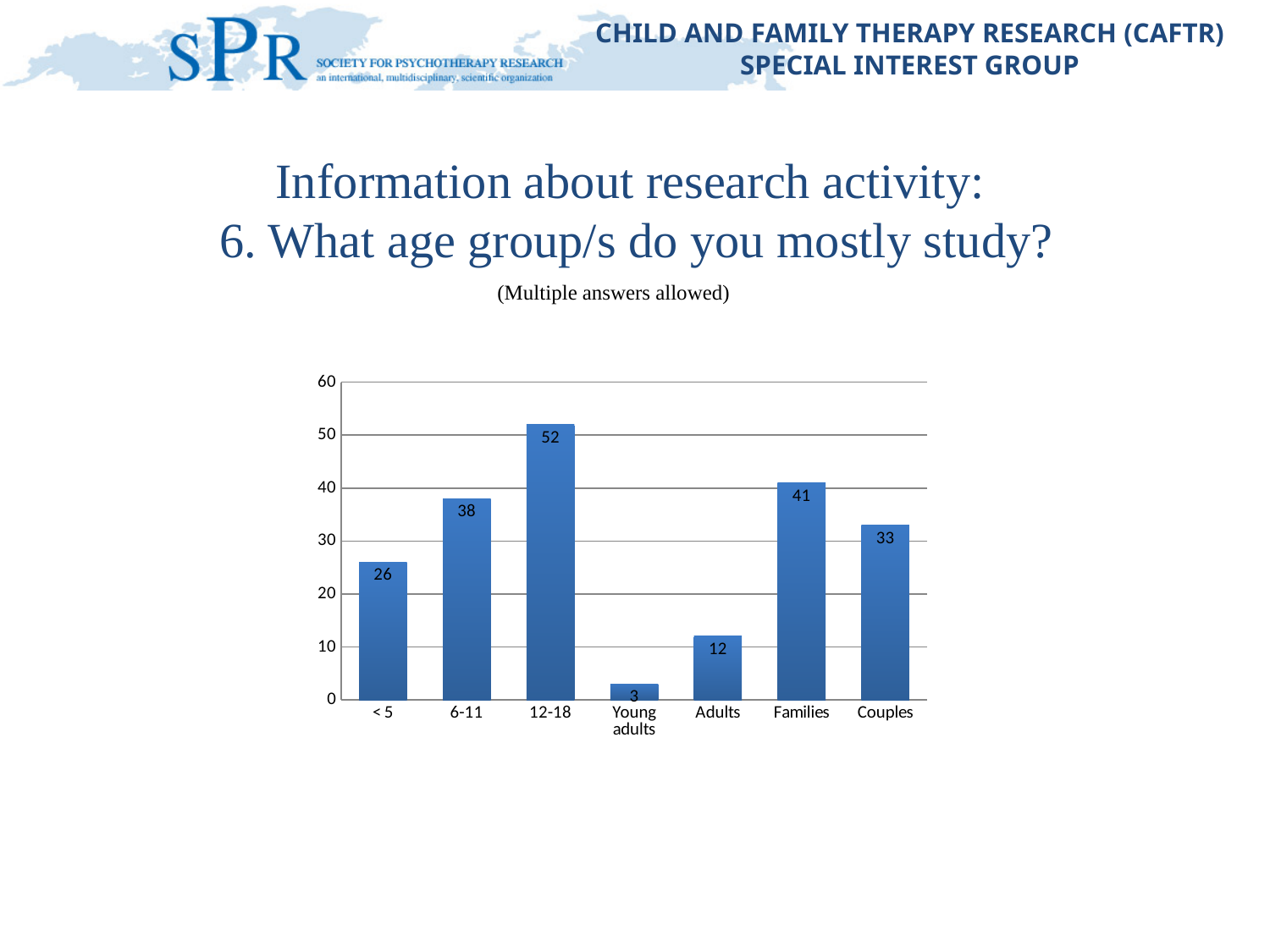
What is the difference between the values for Families and Couples? 8 What is the difference between the values for 12-18 and 6-11? 14 What is the value for Families? 41 Which is larger, the value for < 5 or the value for Adults? < 5 How many categories are shown on the x axis? 7 What kind of chart is shown on the slide? bar chart What is the value for Young adults? 3 Which category has the highest value? 12-18 What is the value for the 6-11 age group? 38 Is the value for Couples greater or less than 30? greater What is the value for the 12-18 age group? 52 Which category has the lowest value? Young adults